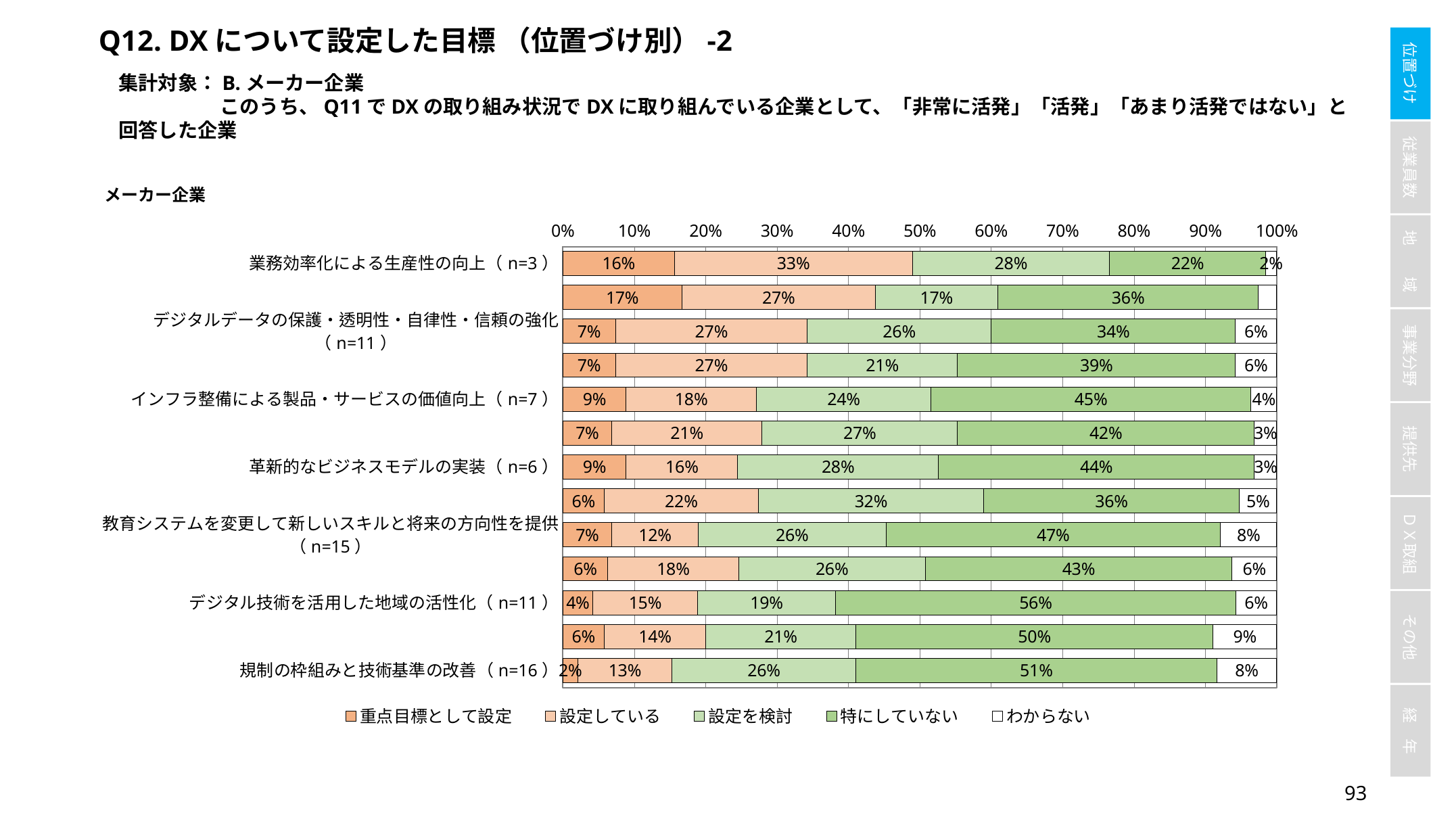
What is the value of 設定している for 業務効率化による生産性の向上 (n=3)? 33% What kind of chart is shown on the slide? stacked bar chart What is the value of 特にしていない for インフラ整備による製品・サービスの価値向上 (n=7)? 45% How many series does the legend list? 5 What is the value of 重点目標として設定 for 業務効率化による生産性の向上 (n=3)? 16% Which series has the largest share in the bar for 業務効率化による生産性の向上 (n=3)? 設定している Which series has the largest share in the bar for 規制の枠組みと技術基準の改善 (n=16)? 特にしていない Which is larger: 設定を検討 for 業務効率化による生産性の向上 (n=3) or 設定を検討 for デジタル技術を活用した地域の活性化 (n=11)? 業務効率化による生産性の向上 (n=3) What is the value of わからない for 革新的なビジネスモデルの実装 (n=6)? 3% What is the value of 設定を検討 for 規制の枠組みと技術基準の改善 (n=16)? 26% What is the value of 特にしていない for デジタル技術を活用した地域の活性化 (n=11)? 56% What is the difference between 特にしていない for デジタル技術を活用した地域の活性化 (n=11) and 特にしていない for 革新的なビジネスモデルの実装 (n=6)? 12%